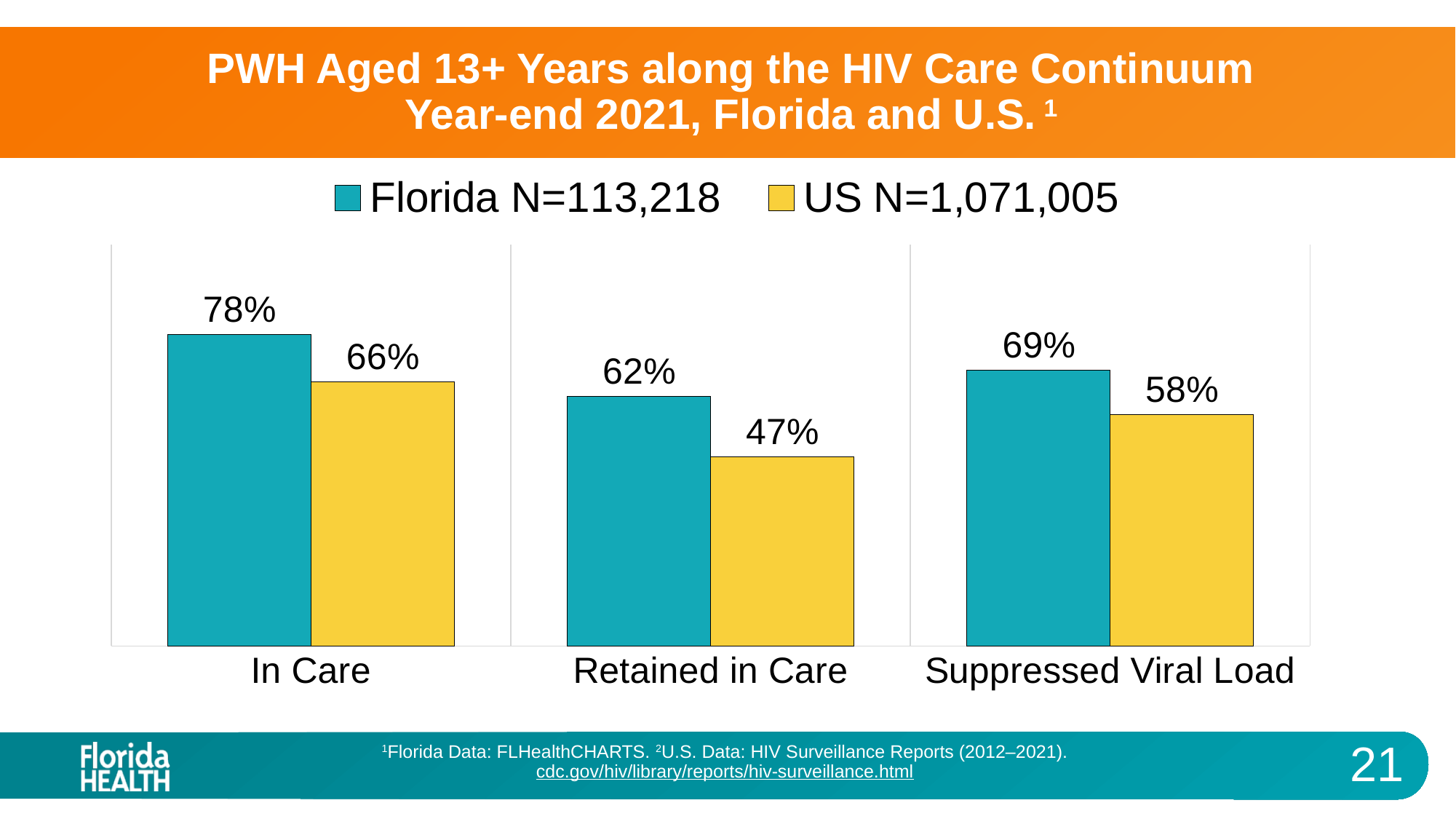
Which is larger for Suppressed Viral Load, the Florida value or the US value? Florida What is the Florida value for Suppressed Viral Load? 69% What is the US value for Suppressed Viral Load? 58% Which category has the highest Florida value? In Care Which category has the lowest US value? Retained in Care What is the US value for Retained in Care? 47% How many series does the legend list? 2 What is the difference between the Florida and US values for In Care? 12% How many categories are shown on the x axis? 3 What is the Florida value for In Care? 78% What kind of chart is shown on the slide? Bar chart What is the difference between the Florida and US values for Retained in Care? 15%